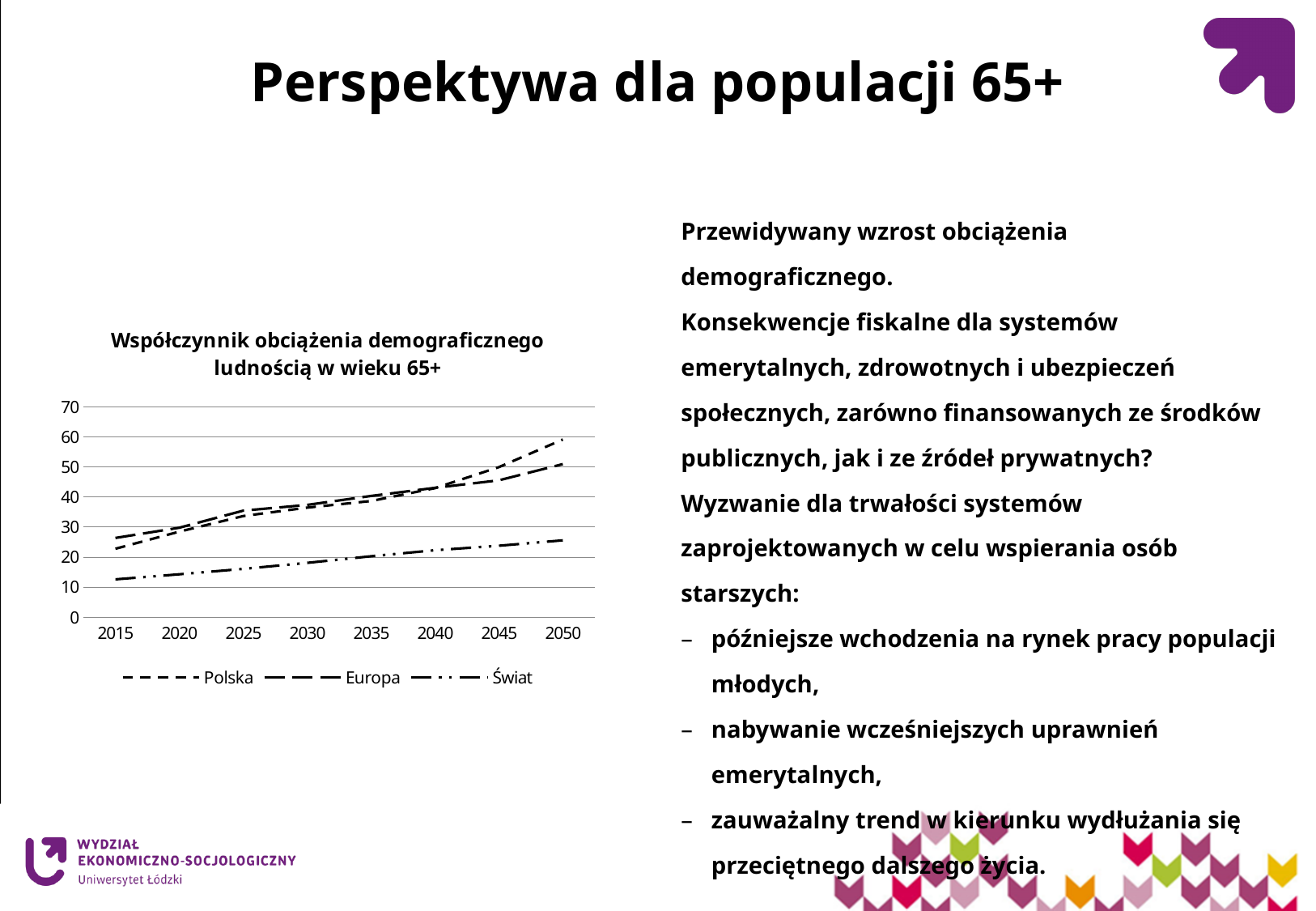
Is the value for Świat in 2015 greater or less than 20? less Is the value for Europa in 2015 greater or less than 20? greater What kind of chart is shown on the slide? line chart What is the title of the chart? Współczynnik obciążenia demograficznego ludnością w wieku 65+ Does the value for Świat rise or fall from 2015 to 2050? rise Which series has the lowest value in 2050? Świat How many series does the chart legend list? 3 Which series are listed in the chart legend? Polska, Europa, Świat Which series has the highest value in 2050? Polska In 2050, which is larger: the value for Polska or the value for Świat? Polska Is the value for Polska in 2050 greater or less than 50? greater How many years are marked on the x axis of the chart? 8